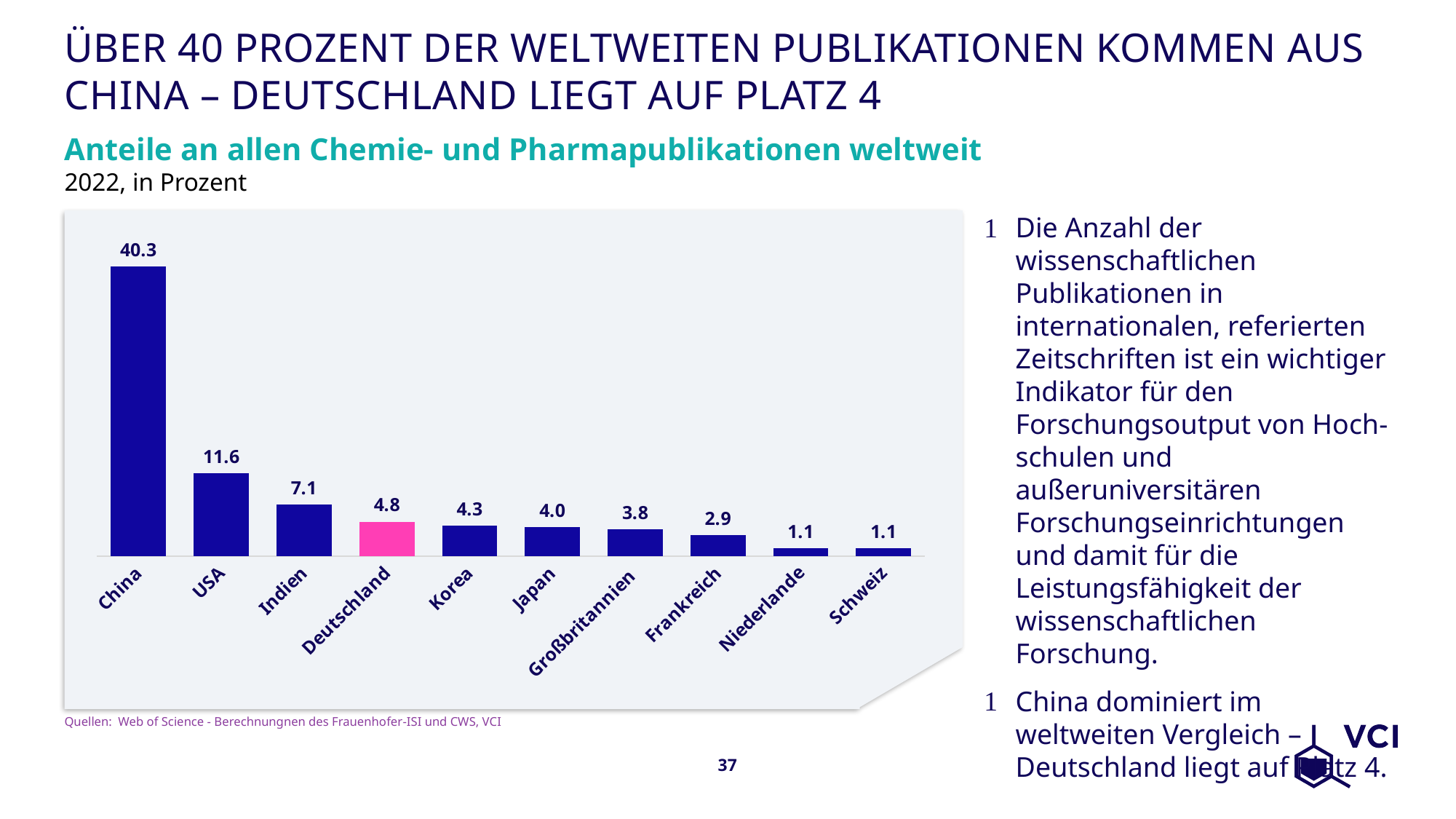
Which is larger, the value for Korea or the value for Japan? Korea Which is larger, the value for Frankreich or the value for Indien? Indien How many countries are shown in the chart? 10 What kind of chart is shown on the slide? Bar chart Which country has the highest share? China What is the value for Großbritannien? 3.8 What is the value for Deutschland? 4.8 What is the value for China? 40.3 Do the values rise or fall from left to right across the chart? Fall Which country's bar is highlighted in pink? Deutschland What is the difference between the values for China and Deutschland? 35.5 What is the difference between the values for USA and Indien? 4.5